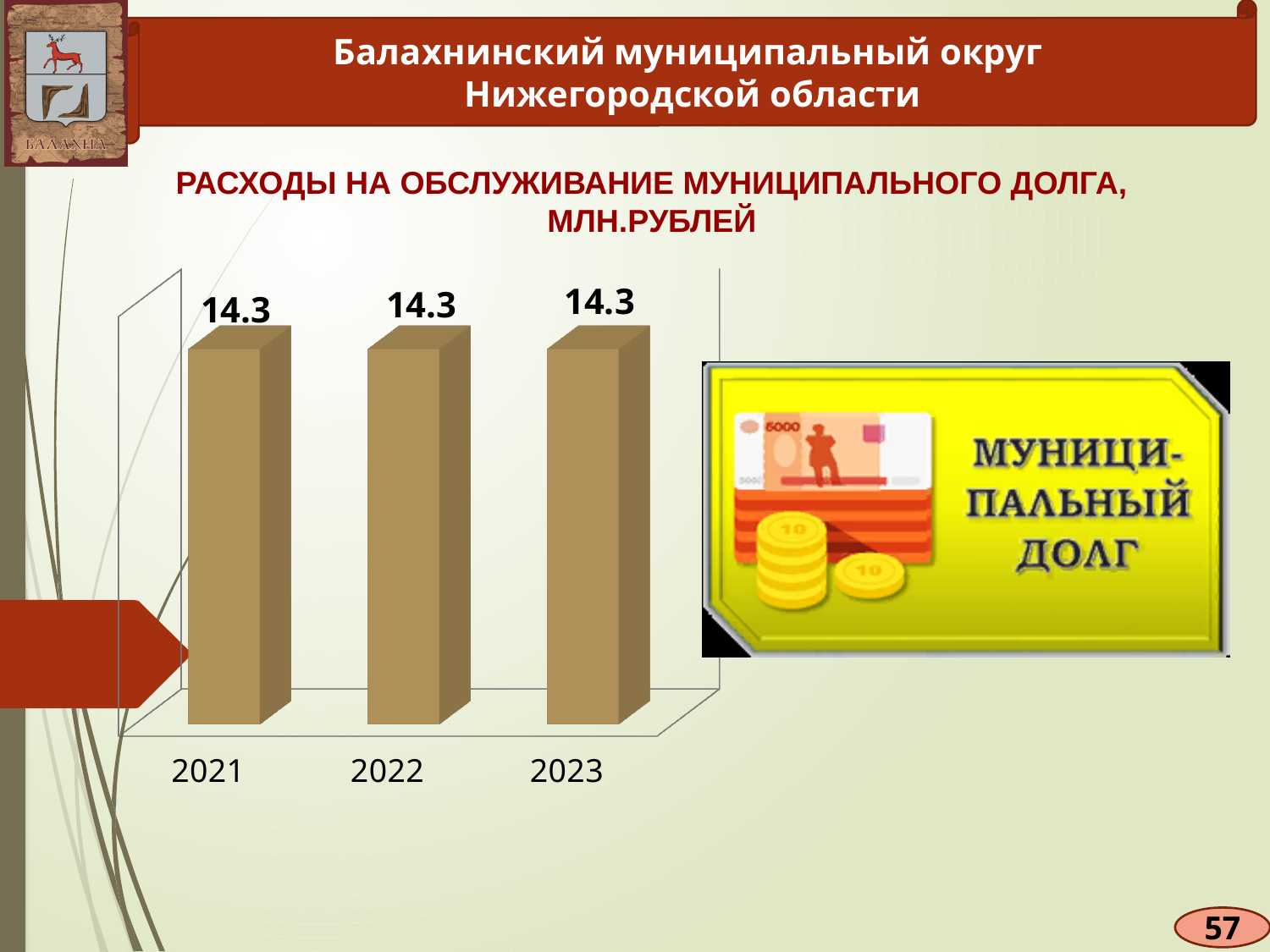
What kind of chart is shown on the slide? bar chart How many years (categories) are shown on the chart? 3 What is the title of the chart? РАСХОДЫ НА ОБСЛУЖИВАНИЕ МУНИЦИПАЛЬНОГО ДОЛГА, МЛН.РУБЛЕЙ Do the values rise, fall or stay the same from 2021 to 2023? stay the same Which year is the first category on the x axis? 2021 What is the value for 2023? 14.3 Which year is the last category on the x axis? 2023 What is the value for 2022? 14.3 In what units are the chart values given? млн.рублей What is the value for 2021? 14.3 What is the difference between the values for 2023 and 2021? 0 Which is larger, the value for 2021 or the value for 2022? they are equal